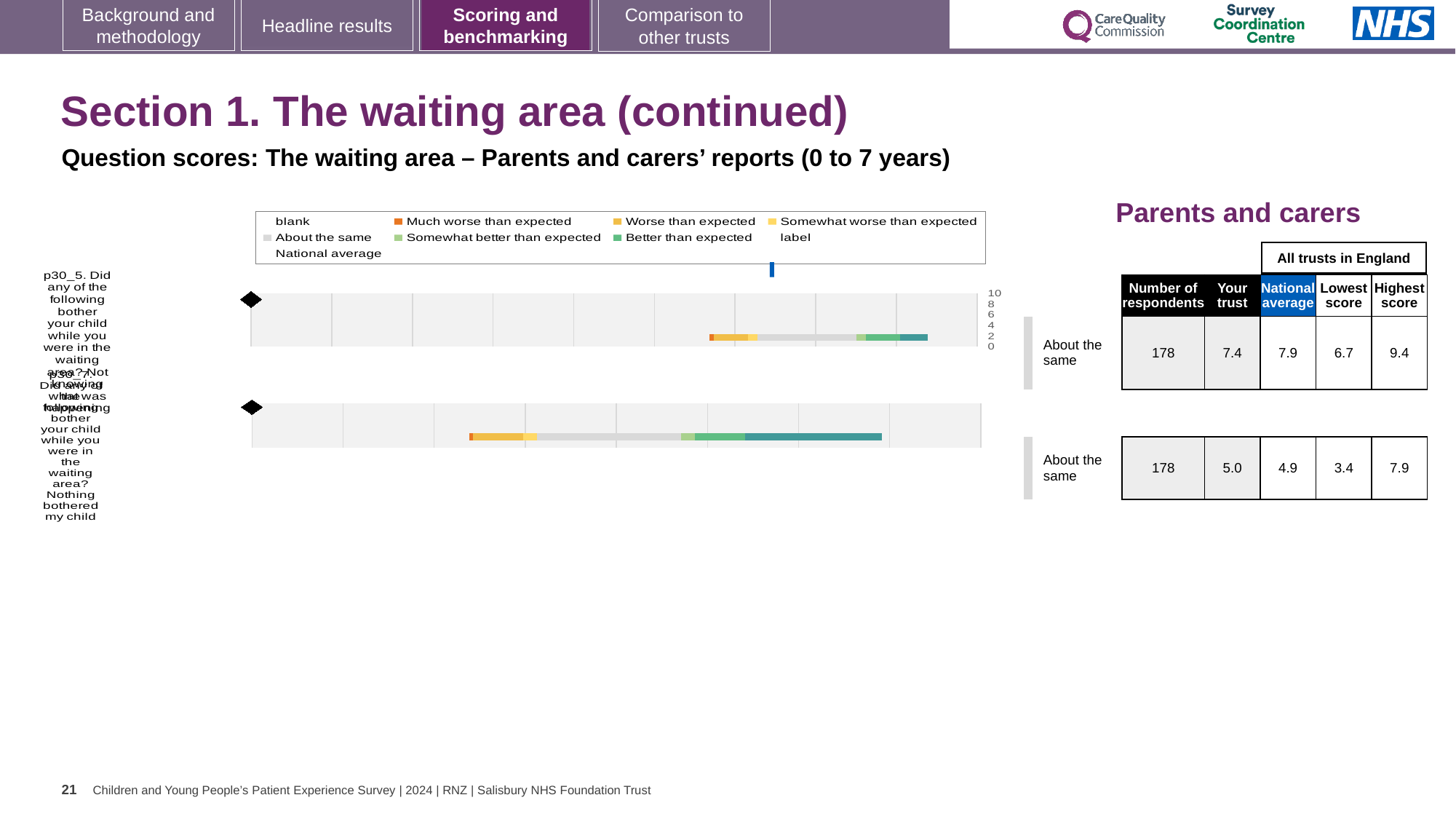
What benchmark category is given for question p30_7 next to the chart? About the same For question p30_5, is the 'Your trust' score higher or lower than the national average? lower How many question bars are plotted on the slide? 2 What kind of chart is used to show the question scores on this slide? bar chart In the chart legend, which category is shown in light grey? About the same In the table beside the chart, what is the number of respondents for question p30_5? 178 In the table beside the chart, what is the highest score for question p30_7? 7.9 In the table beside the chart, what is the 'Your trust' score for question p30_5? 7.4 In the table beside the chart, what is the national average for question p30_7? 4.9 How many entries does the chart legend list? 9 For question p30_5, what is the difference between the highest score and the lowest score in the table? 2.7 In the chart legend, what colour represents 'Much worse than expected'? orange